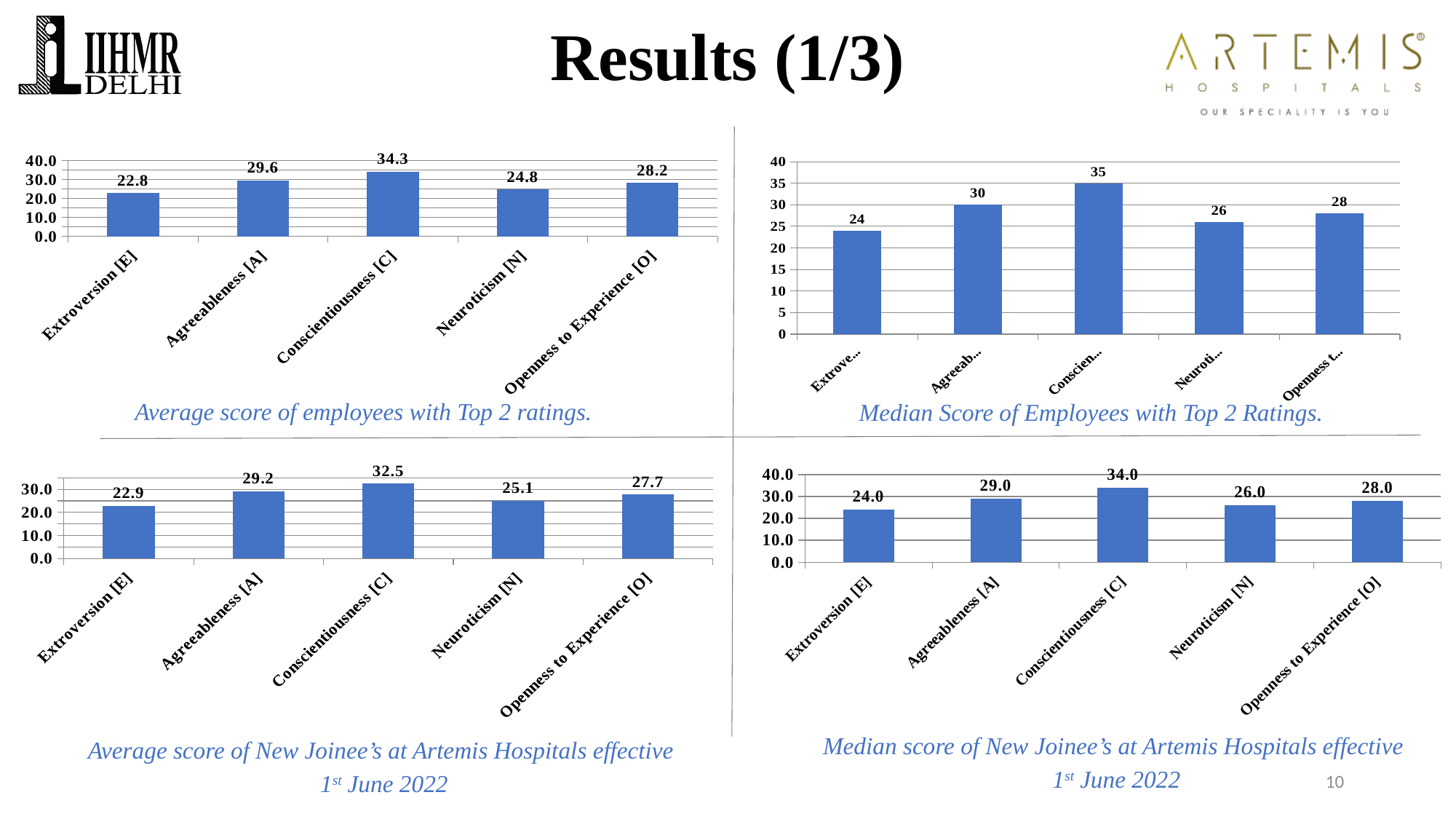
What type of chart is the top-right chart (Median Score of Employees with Top 2 Ratings)? Bar chart In the top-left chart (Average score of employees with Top 2 ratings), what is the value for Conscientiousness [C]? 34.3 In the top-right chart (Median Score of Employees with Top 2 Ratings), what is the difference between the Agreeableness bar and the Extroversion bar? 6 In the bottom-left chart (Average score of New Joinee's at Artemis Hospitals), which category has the highest value? Conscientiousness [C] In the top-left chart (Average score of employees with Top 2 ratings), is the value for Openness to Experience [O] greater or less than 30.0? less In the bottom-right chart (Median score of New Joinee's at Artemis Hospitals), which is larger: Agreeableness [A] or Neuroticism [N]? Agreeableness [A] In the top-right chart (Median Score of Employees with Top 2 Ratings), what is the value for the Conscientiousness bar? 35 In the bottom-right chart (Median score of New Joinee's at Artemis Hospitals), what is the value for Openness to Experience [O]? 28.0 In the top-left chart (Average score of employees with Top 2 ratings), which category has the lowest value? Extroversion [E] How many categories are shown in the top-left chart (Average score of employees with Top 2 ratings)? 5 In the bottom-left chart (Average score of New Joinee's at Artemis Hospitals), what is the value for Neuroticism [N]? 25.1 In the bottom-right chart (Median score of New Joinee's at Artemis Hospitals), what is the difference between Conscientiousness [C] and Extroversion [E]? 10.0